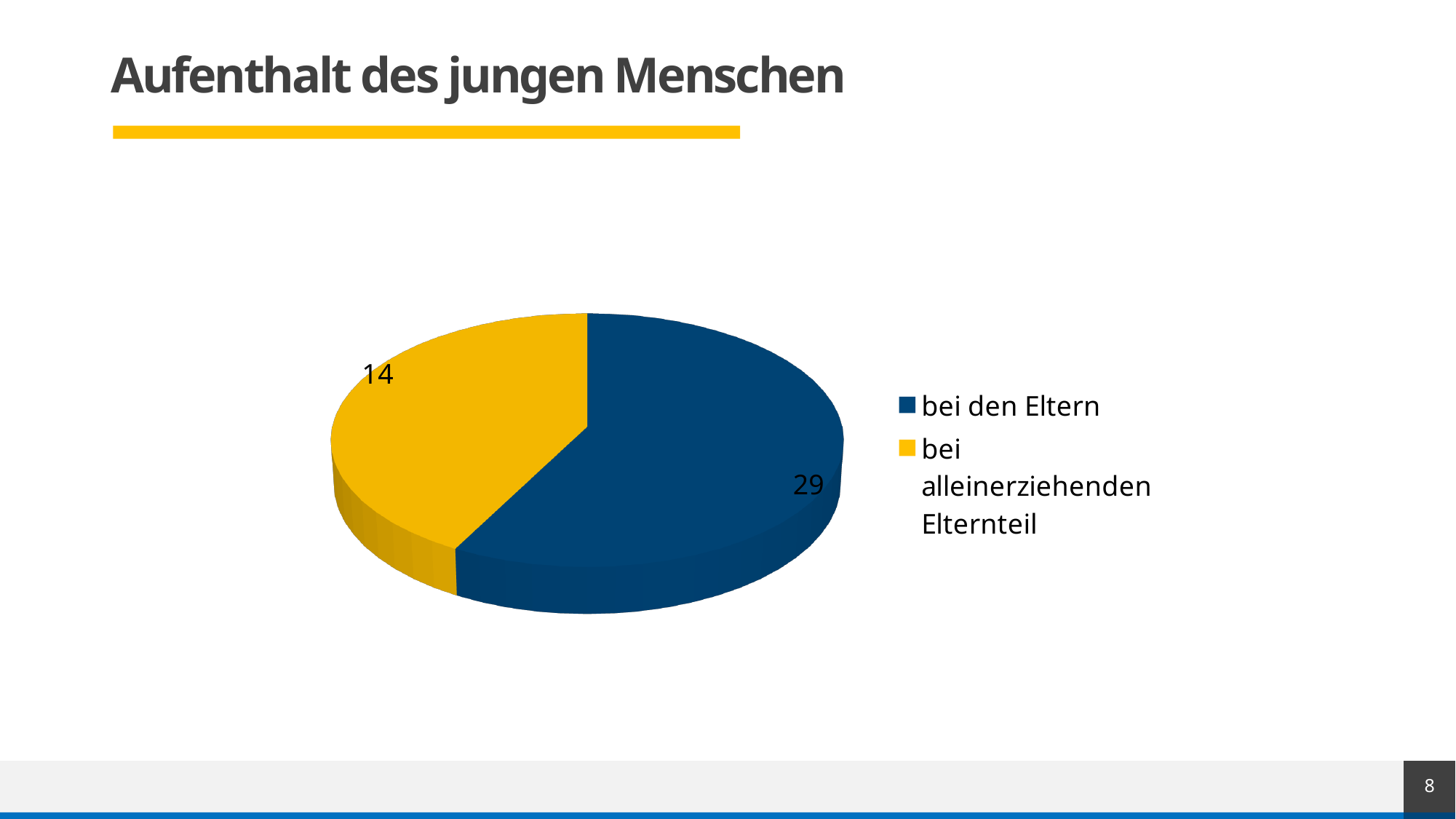
What colour is the slice for "bei alleinerziehenden Elternteil"? yellow What is the total of the two slices? 43 How many entries does the legend list? 2 What is the value for "bei den Eltern"? 29 What is the value for "bei alleinerziehenden Elternteil"? 14 Which is larger: "bei den Eltern" or "bei alleinerziehenden Elternteil"? bei den Eltern Which category has the largest slice? bei den Eltern How many slices does the pie chart have? 2 Which category has the smallest slice? bei alleinerziehenden Elternteil What is the title of the slide? Aufenthalt des jungen Menschen What is the difference between the values for "bei den Eltern" and "bei alleinerziehenden Elternteil"? 15 What kind of chart is shown on the slide? pie chart